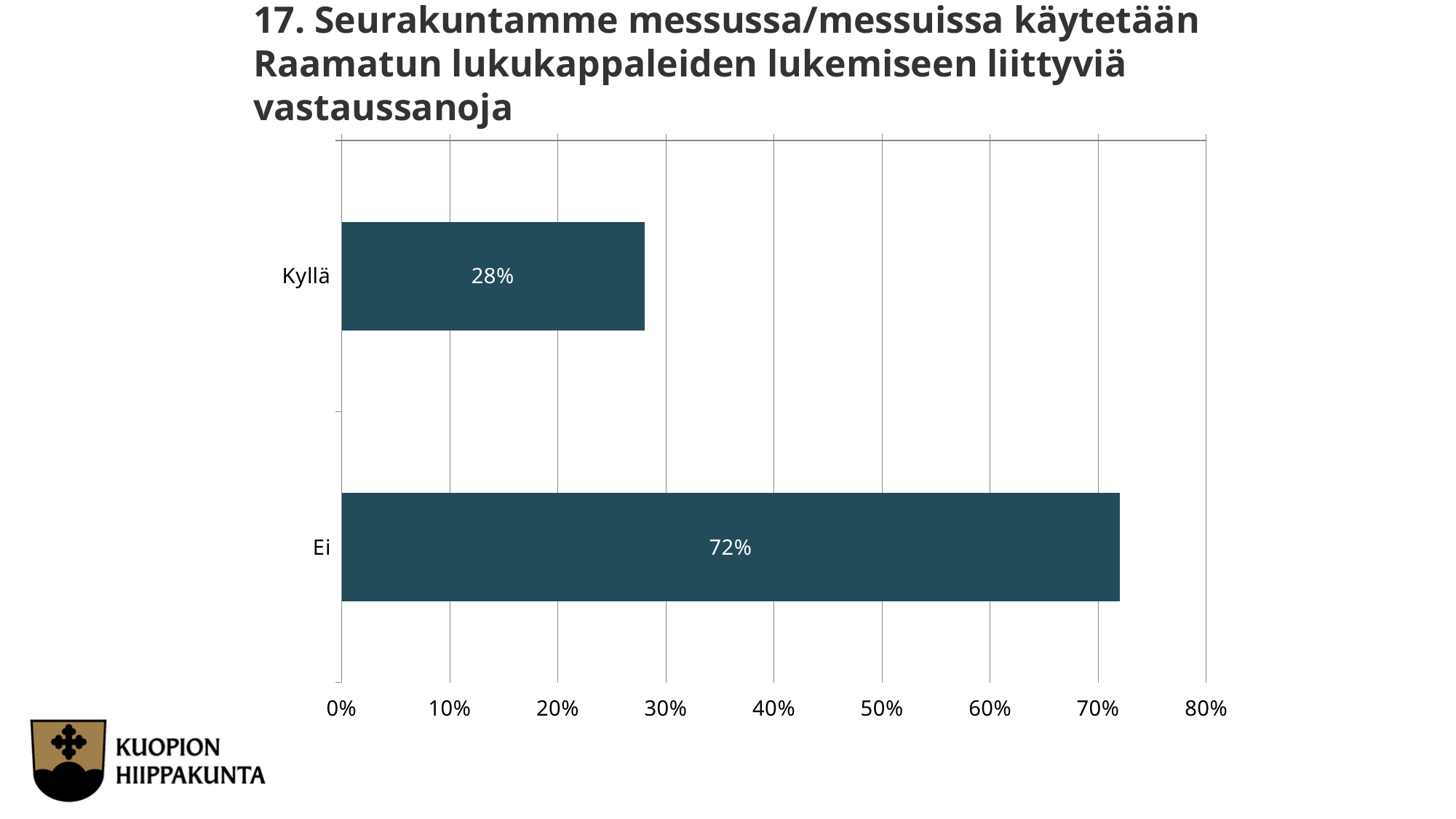
Is the value for Ei greater or less than 50%? greater What number does the chart title begin with? 17 Which category has the lowest value? Kyllä Which is larger, the value for Kyllä or the value for Ei? Ei What is the maximum value shown on the horizontal axis? 80% Is the value for Kyllä greater or less than 30%? less What is the difference between the values for Ei and Kyllä? 44% Which category has the highest value? Ei How many categories are shown in the chart? 2 What kind of chart is shown on the slide? bar chart What is the value for Kyllä? 28% What is the value for Ei? 72%